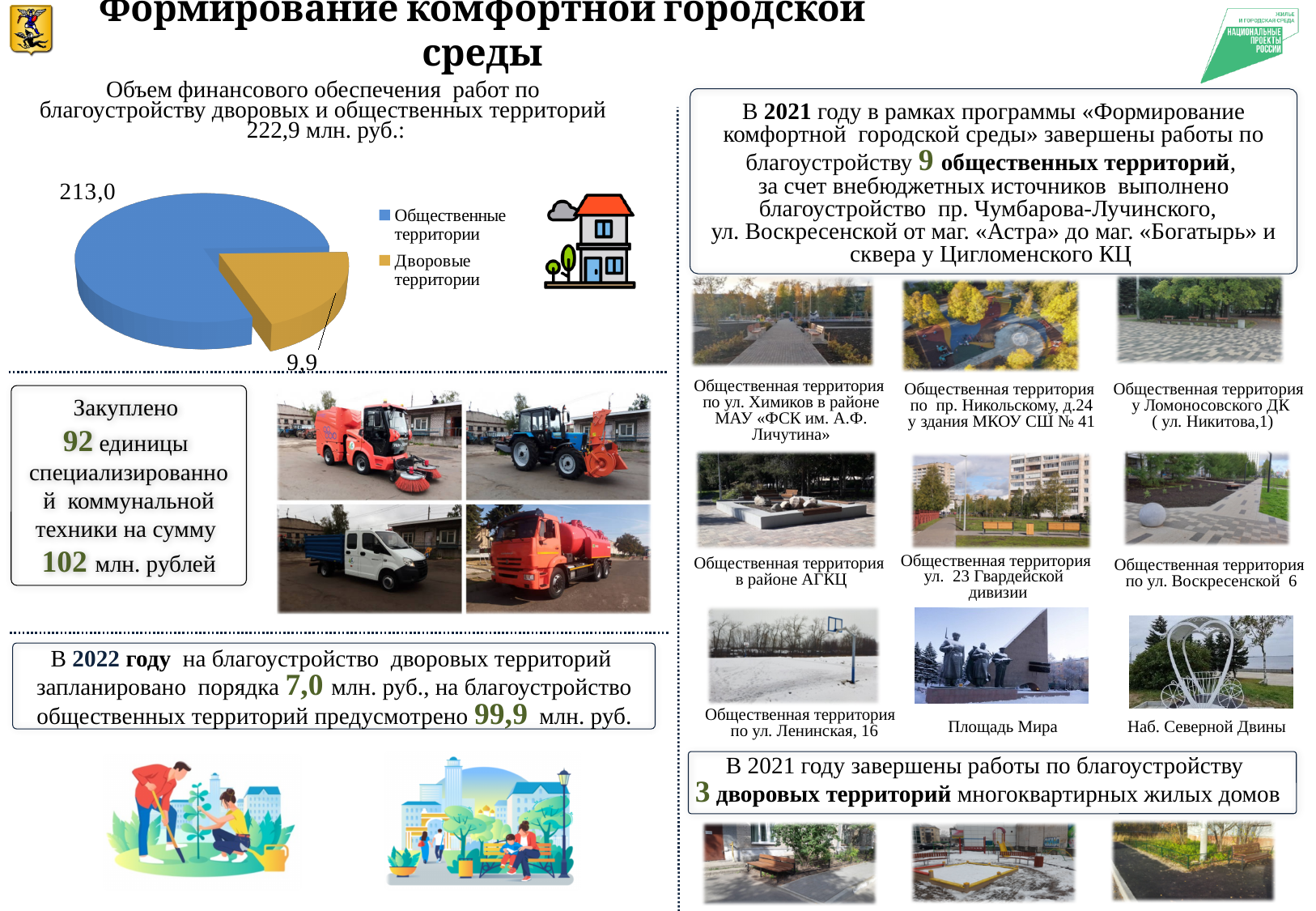
What is the value for Дворовые территории in the pie chart? 9,9 What is the value for Общественные территории in the pie chart? 213,0 What colour is the Дворовые территории slice in the pie chart? Gold (yellow-brown) How many categories does the pie chart show? 2 Which category has the smallest slice in the pie chart? Дворовые территории Which category has the largest slice in the pie chart? Общественные территории What type of chart is shown on the slide? Pie chart What colour is the Общественные территории slice in the pie chart? Blue Which is larger in the pie chart: Общественные территории or Дворовые территории? Общественные территории How many entries does the legend of the pie chart list? 2 What is the total of the two values shown in the pie chart, as stated in the chart heading? 222,9 млн. руб. What is the difference between the values for Общественные территории and Дворовые территории in the pie chart? 203,1